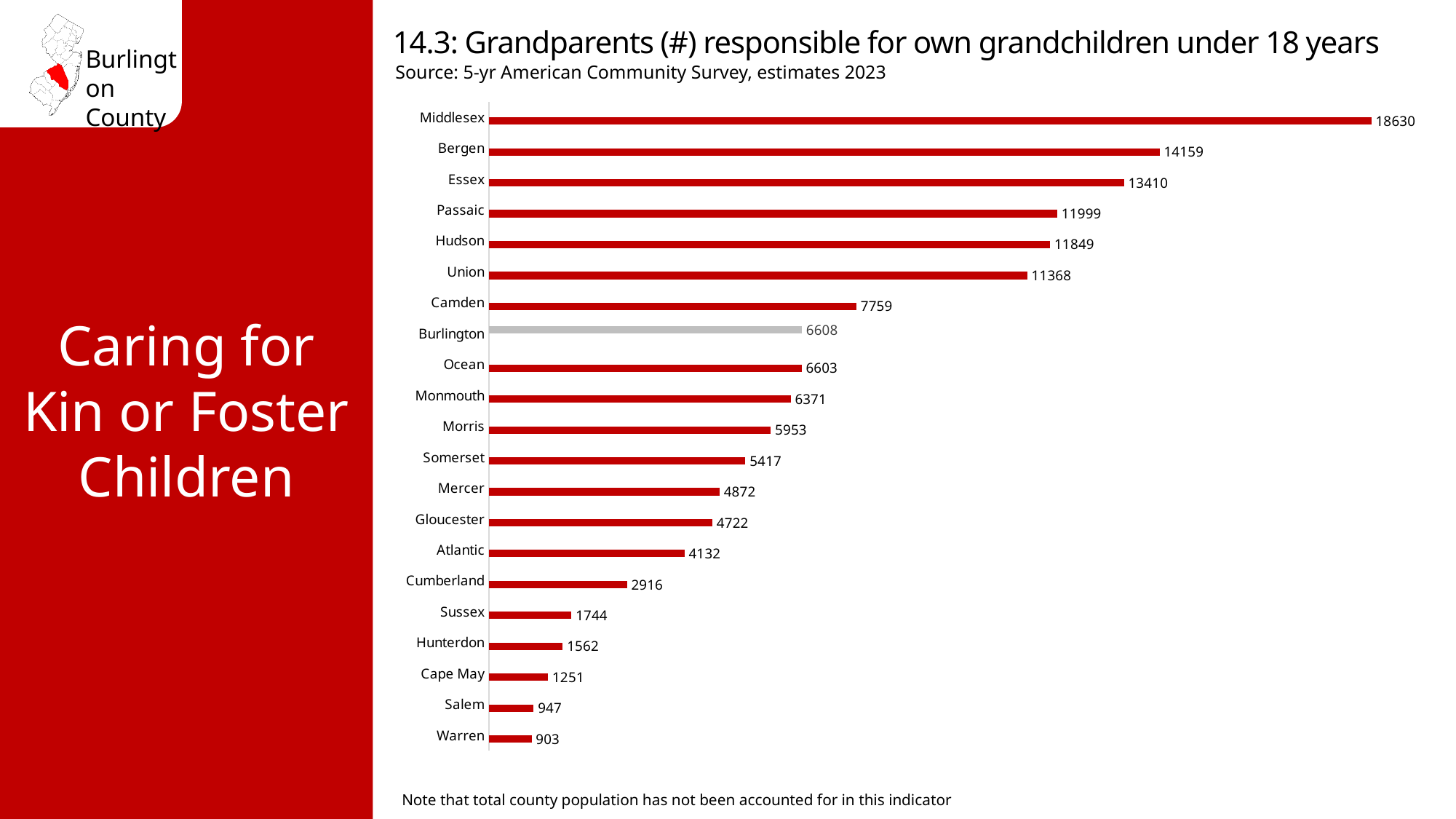
What kind of chart is shown on the slide? Bar chart What is the value for Cape May? 1251 What is the value for Burlington? 6608 Which county's bar is shown in grey instead of red? Burlington What is the difference between the values for Middlesex and Bergen? 4471 What is the value for Camden? 7759 Which county has the lowest value? Warren How many counties are shown in the chart? 21 Which has a larger value, Mercer or Atlantic? Mercer Which county has the highest value? Middlesex What is the difference between the values for Camden and Burlington? 1151 Which has a larger value, Passaic or Union? Passaic